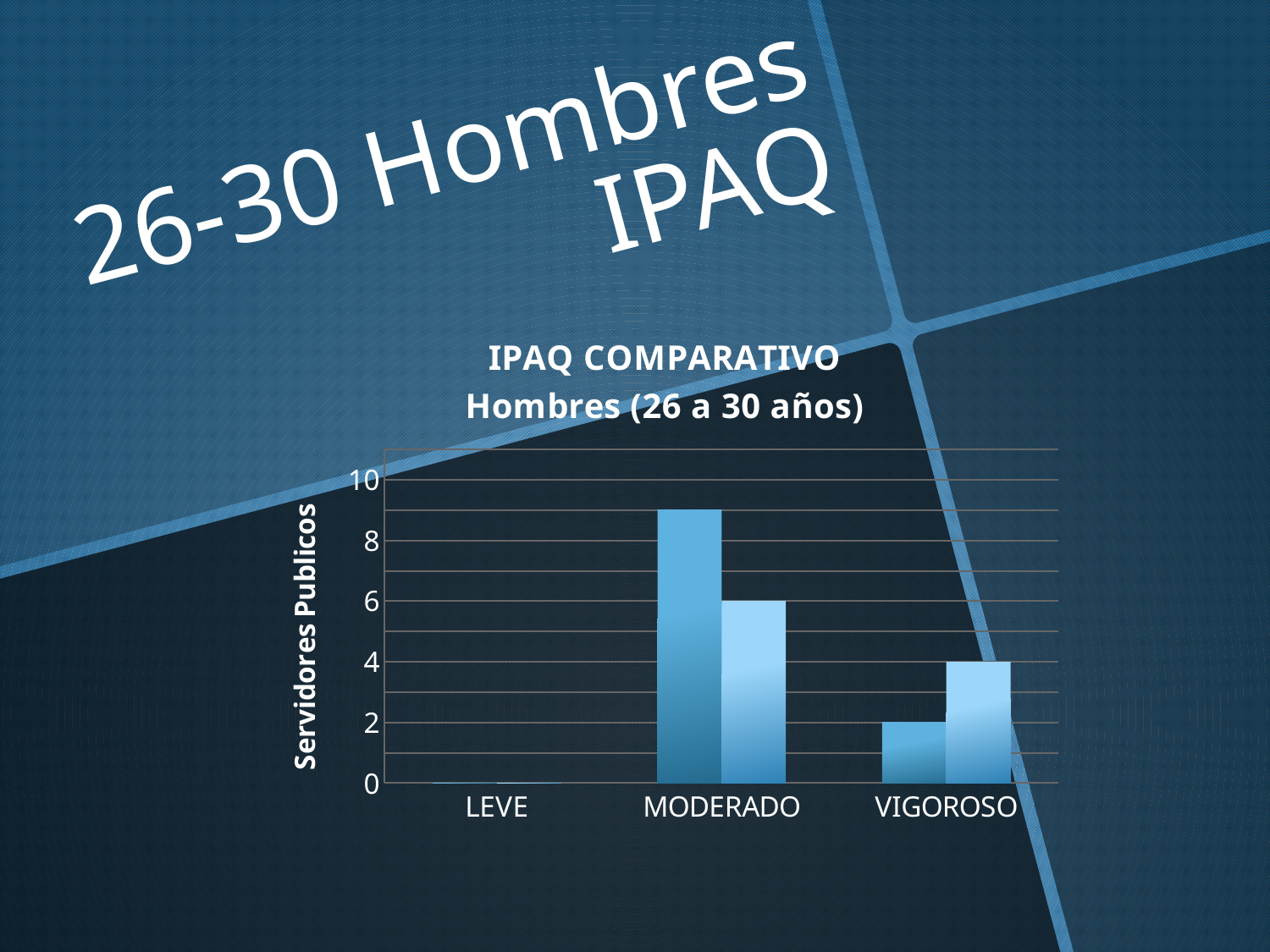
Which category shows no visible bars in the chart? LEVE What is the value of the lighter blue bar for MODERADO? 6 Which category has the taller lighter blue bar, MODERADO or VIGOROSO? MODERADO Which category has the tallest bar in the chart? MODERADO What is the difference between the lighter blue bar and the darker blue bar for VIGOROSO? 2 For VIGOROSO, which bar is taller, the darker blue bar or the lighter blue bar? the lighter blue bar How many categories are shown on the x axis of the chart? 3 What kind of chart is shown on the slide? bar chart Is the value of the darker blue bar for MODERADO greater or less than 8? greater What is the value of the lighter blue bar for VIGOROSO? 4 What is the value of the darker blue bar for VIGOROSO? 2 What is the title of the vertical axis of the chart? Servidores Publicos